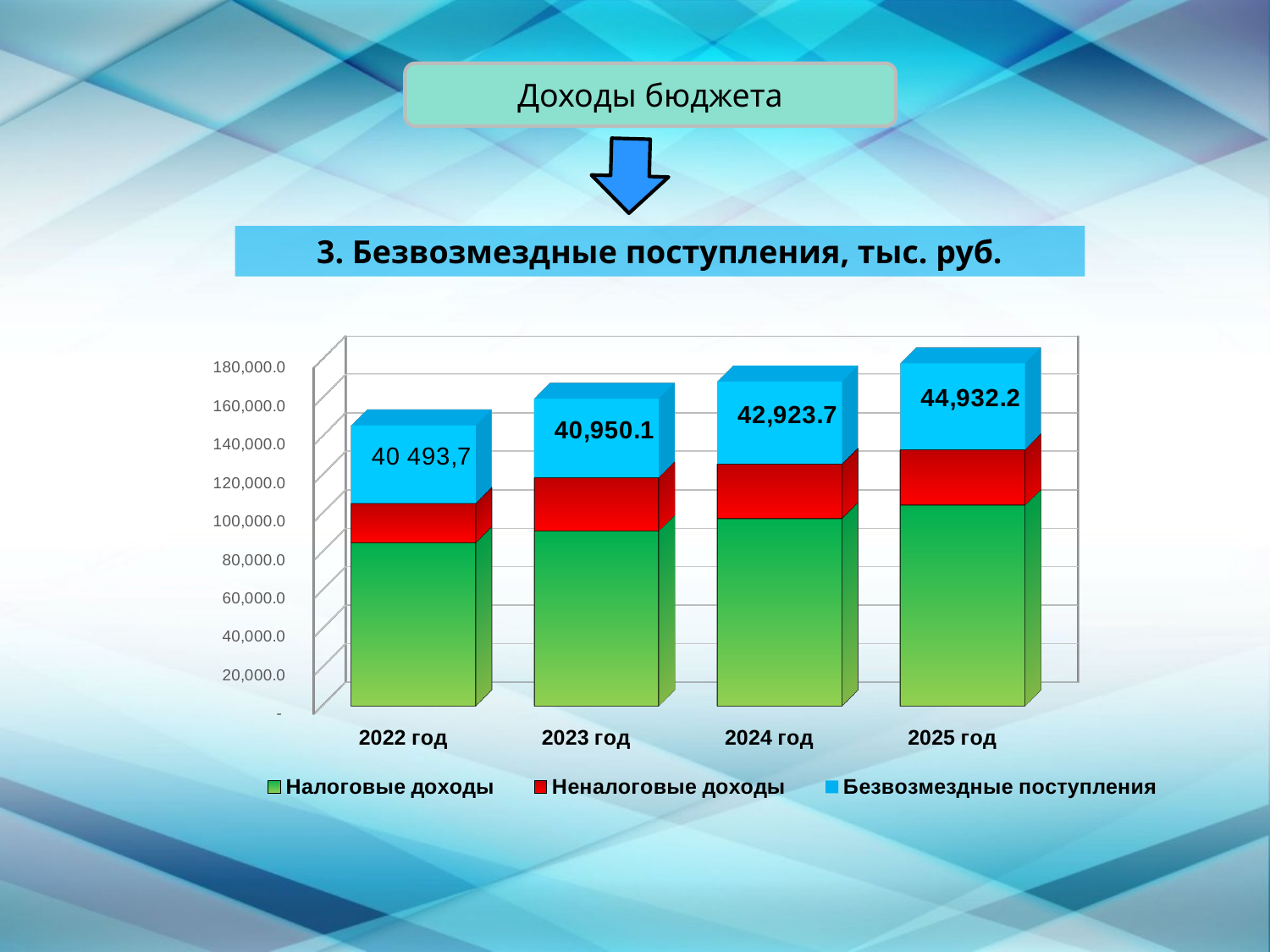
Which is larger, the Безвозмездные поступления value for 2023 год or for 2024 год? 2024 год Which year has the highest value of Безвозмездные поступления? 2025 год What is the value of Безвозмездные поступления for 2023 год? 40,950.1 What is the value of Безвозмездные поступления for 2022 год? 40 493,7 How many years are shown on the x axis of the chart? 4 Which year has the lowest value of Безвозмездные поступления? 2022 год What is the value of Безвозмездные поступления for 2025 год? 44,932.2 What is the difference between the Безвозмездные поступления values for 2025 год and 2024 год? 2,008.5 Do the values of Безвозмездные поступления rise or fall from 2022 год to 2025 год? rise What is the value of Безвозмездные поступления for 2024 год? 42,923.7 How many series does the chart legend list? 3 Is the value of Налоговые доходы for 2022 год greater or less than 100,000.0? less